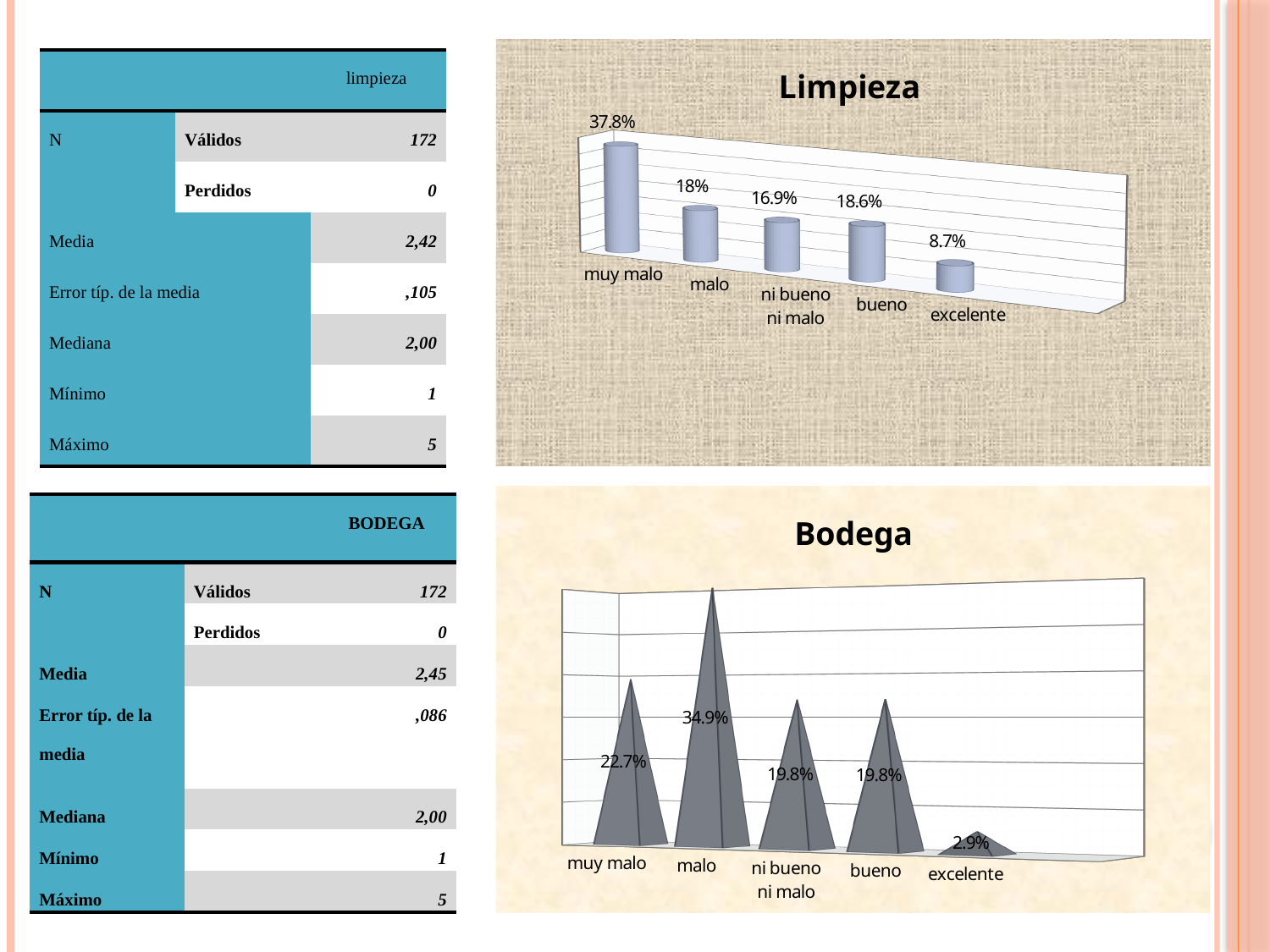
In the Limpieza chart, what is the value for excelente? 8.7% In the Bodega chart, what is the difference between the values for malo and muy malo? 12.2% In the Limpieza chart, how many categories are shown? 5 In the Bodega chart, which is larger, the value for muy malo or the value for bueno? muy malo In the Bodega chart, what is the value for malo? 34.9% In the Limpieza chart, which category has the lowest value? excelente In the Bodega chart, which category has the highest value? malo In the Limpieza chart, which category has the highest value? muy malo In the Bodega chart, what is the value for excelente? 2.9% In the Limpieza chart, what is the value for muy malo? 37.8% In the Limpieza chart, what is the difference between the values for muy malo and malo? 19.8% What kind of chart is the Limpieza chart? bar chart